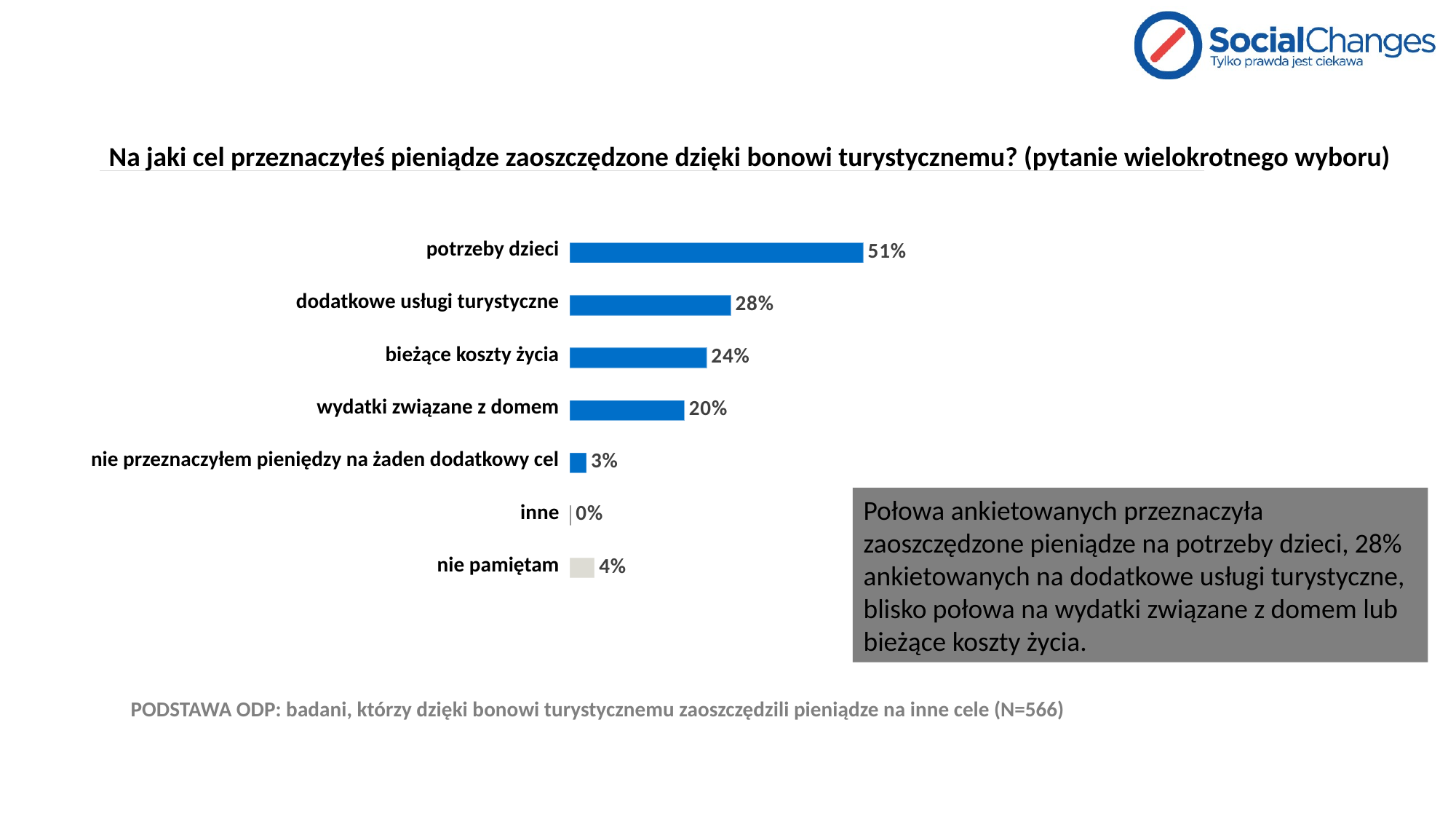
How many categories are shown in the chart? 7 Which category's bar is shown in a different (grey) colour from the others? nie pamiętam Which category has the highest value? potrzeby dzieci Which is larger: the value for "wydatki związane z domem" or the value for "nie przeznaczyłem pieniędzy na żaden dodatkowy cel"? wydatki związane z domem What is the value for "potrzeby dzieci"? 51% What is the value for "bieżące koszty życia"? 24% What is the value for "dodatkowe usługi turystyczne"? 28% What is the difference between the values for "potrzeby dzieci" and "dodatkowe usługi turystyczne"? 23% What is the value for "nie pamiętam"? 4% Which category has the lowest value? inne What kind of chart is shown on the slide? bar chart What is the difference between the values for "bieżące koszty życia" and "wydatki związane z domem"? 4%